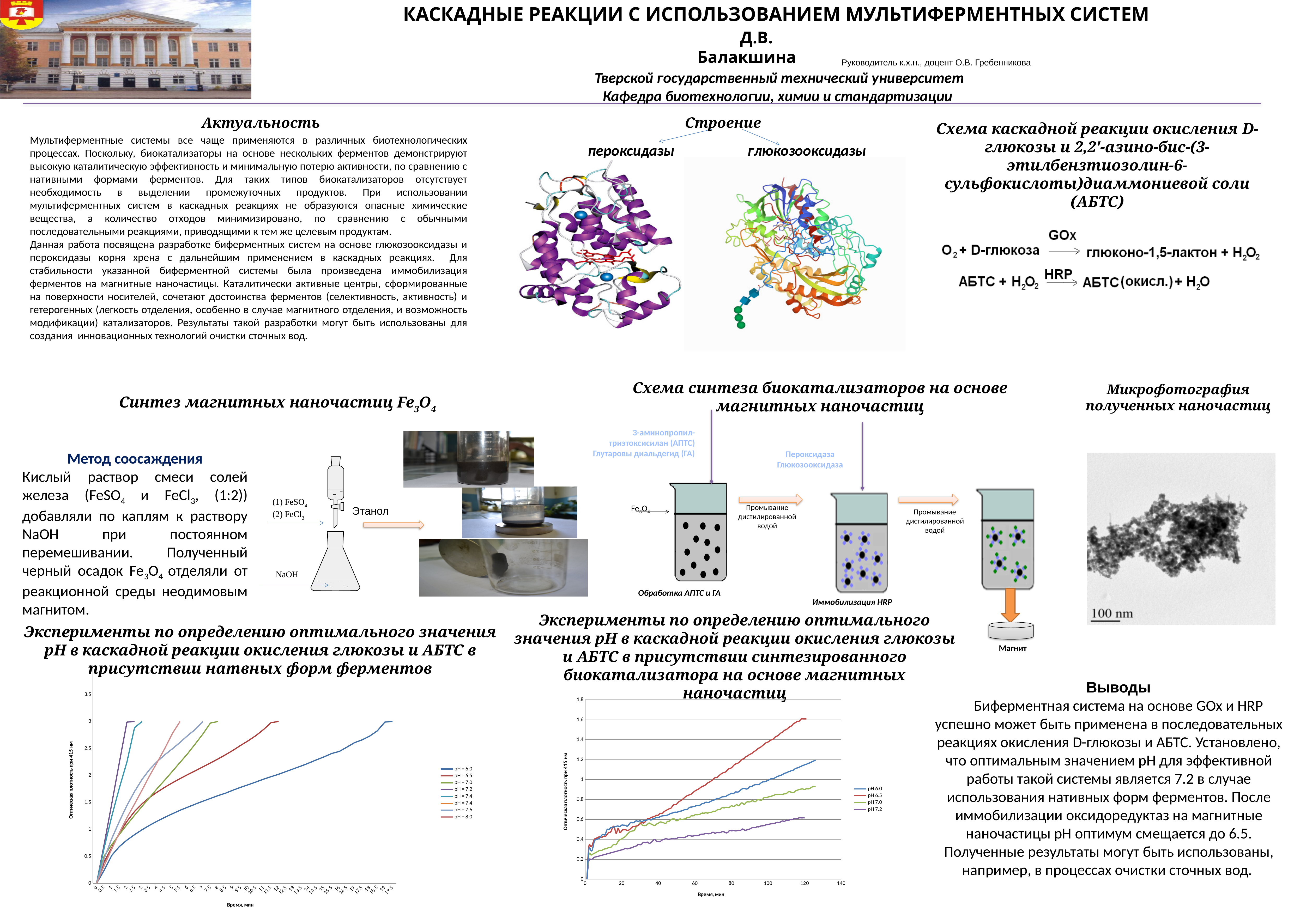
What is the y-axis label of the right chart (magnetic nanoparticle biocatalyst)? Оптическая плотность при 415 нм How many series does the legend of the right chart (magnetic nanoparticle biocatalyst) list? 4 In the right chart (magnetic nanoparticle biocatalyst), which series has the larger final optical density, pH 6.0 or pH 7.0? pH 6.0 In the right chart (magnetic nanoparticle biocatalyst), which pH series reaches the highest optical density? pH 6.5 What kind of chart is the right chart (immobilized biocatalyst on magnetic nanoparticles)? line chart What kind of chart is the left chart (native enzyme forms, 'в присутствии нативных форм ферментов')? line chart How many series does the legend of the left chart (native enzyme forms) list? 8 In the right chart (magnetic nanoparticle biocatalyst), which pH series has the lowest optical density at the end of the measurement? pH 7.2 In the right chart (magnetic nanoparticle biocatalyst), is the final optical density for pH 7.2 greater or less than 0.8? less In the left chart (native enzyme forms), do the optical density values rise or fall over time? rise In the right chart (magnetic nanoparticle biocatalyst), is the final optical density for pH 6.5 greater or less than 1.4? greater In the left chart (native enzyme forms), which pH series takes the longest time to reach an optical density of 3? pH = 6,0